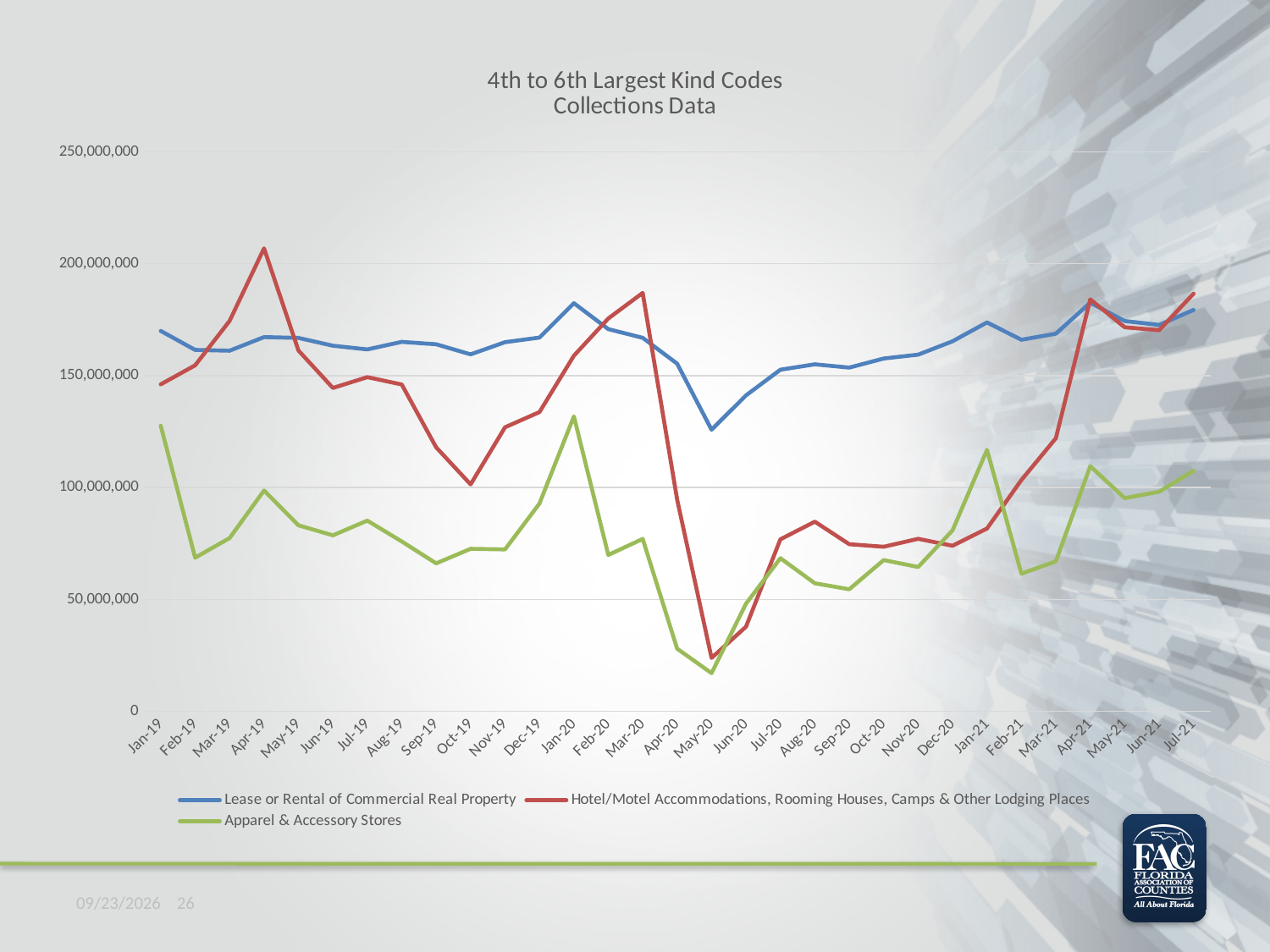
Which series is drawn in green? Apparel & Accessory Stores In which month does the Hotel/Motel Accommodations, Rooming Houses, Camps & Other Lodging Places series reach its highest value? Apr-19 In May-20, which is larger: Lease or Rental of Commercial Real Property or Hotel/Motel Accommodations, Rooming Houses, Camps & Other Lodging Places? Lease or Rental of Commercial Real Property Is the value for Hotel/Motel Accommodations, Rooming Houses, Camps & Other Lodging Places in Apr-19 greater or less than 200,000,000? greater What kind of chart is shown on the slide? Line chart How many series does the legend list? 3 In which month does the Apparel & Accessory Stores series reach its lowest value? May-20 Is the value for Hotel/Motel Accommodations, Rooming Houses, Camps & Other Lodging Places in May-20 greater or less than 50,000,000? less How many months are plotted along the x axis? 31 Is the value for Apparel & Accessory Stores in Jan-20 greater or less than 100,000,000? greater What is the title of the chart? 4th to 6th Largest Kind Codes Collections Data